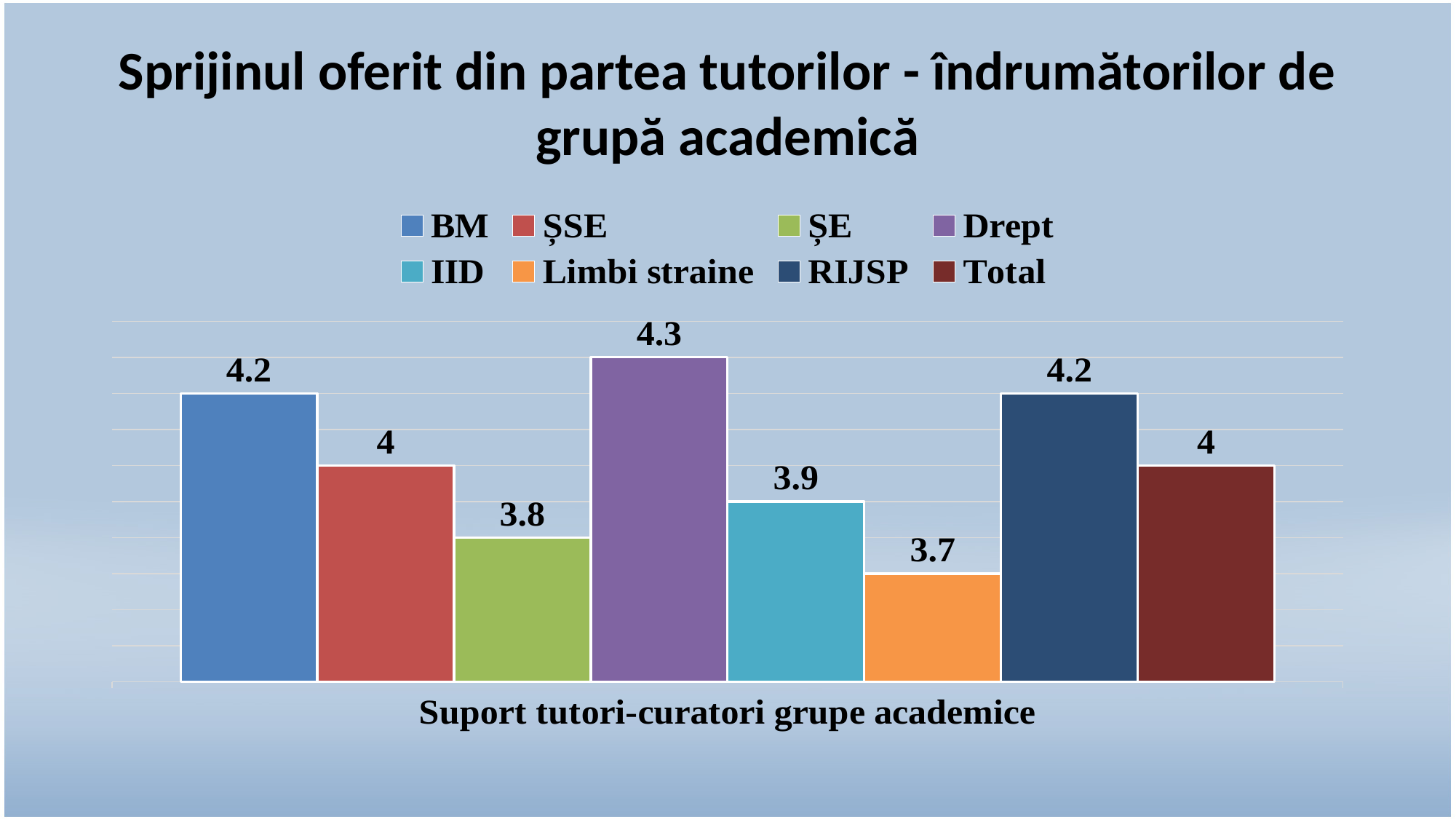
What is the label shown on the x axis below the bars? Suport tutori-curatori grupe academice What is the value for Limbi straine? 3.7 What is the value for IID? 3.9 What kind of chart is shown on the slide? Bar chart What is the difference between the values for BM and ȘE? 0.4 What is the value for Total? 4 Which is larger, the value for ȘSE or the value for ȘE? ȘSE What is the difference between the values for Drept and Limbi straine? 0.6 Which series has the highest value? Drept Which series has the lowest value? Limbi straine What is the value for Drept? 4.3 How many series does the legend list? 8